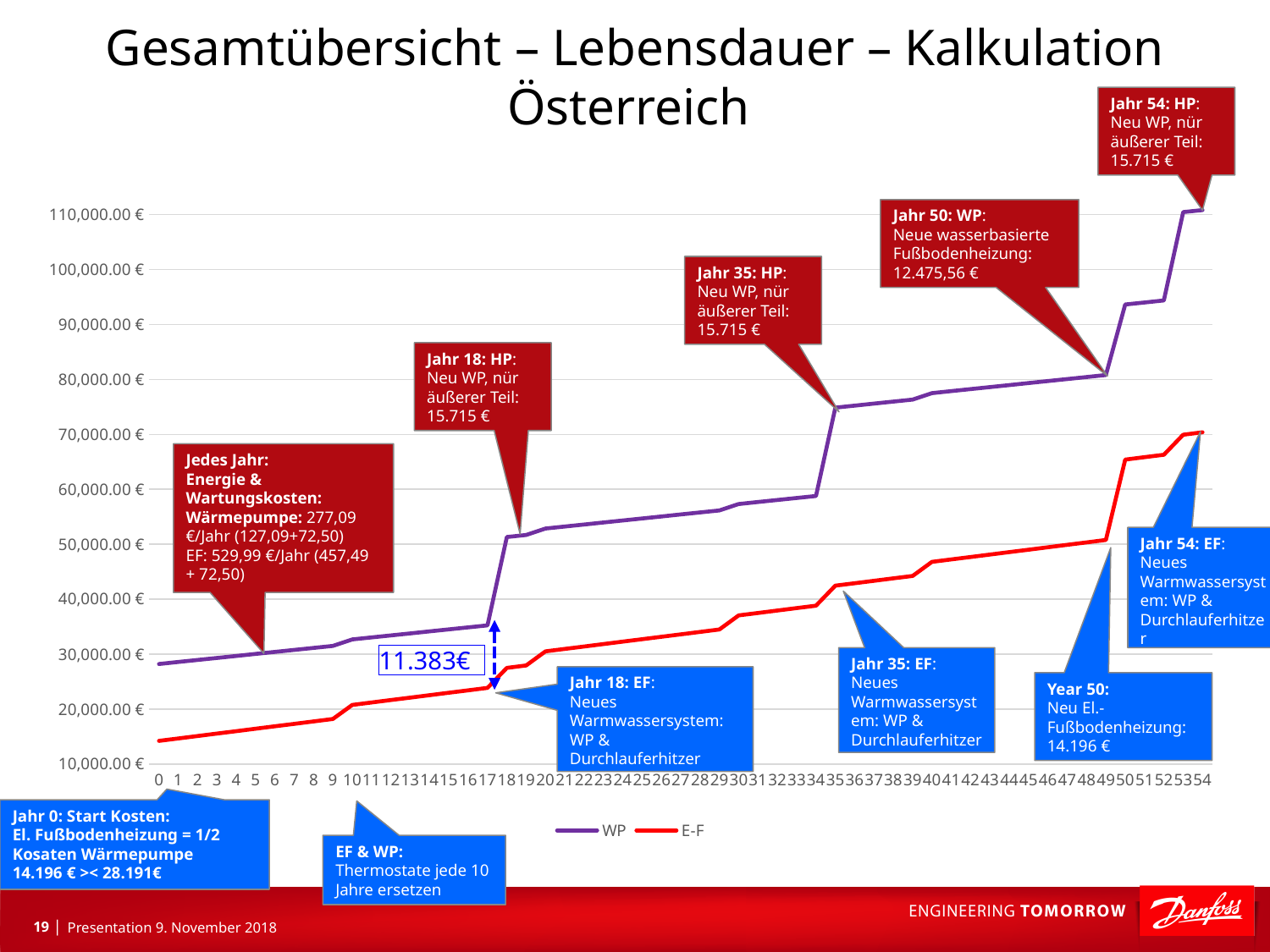
Do the values of the E-F series rise or fall as the year increases along the x axis? rise What value does the annotation between the WP and E-F lines at year 18 show? 11.383€ Is the value of the E-F series at year 0 greater or less than 20,000.00 €? less Is the value of the WP series at year 35 greater or less than 70,000.00 €? greater What are the two series named in the chart legend? WP and E-F What kind of chart is shown on the slide? line chart Is the value of the E-F series at year 54 greater or less than 60,000.00 €? greater How many series does the chart legend list? 2 Do the values of the WP series rise or fall as the year increases along the x axis? rise At year 54, which series has the higher value, WP or E-F? WP